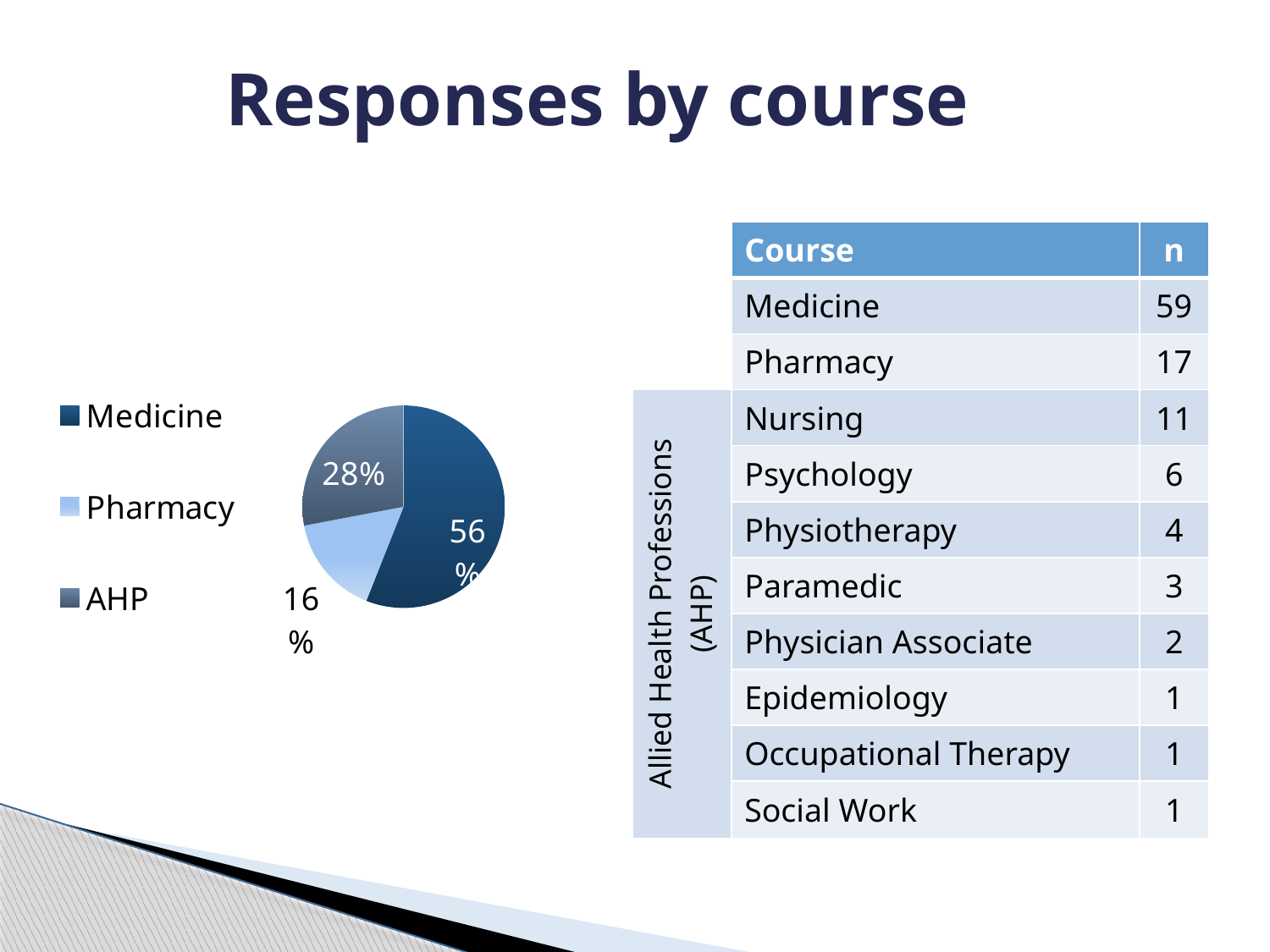
Which category has the smallest slice of the pie chart? Pharmacy What percentage of the pie chart is Pharmacy? 16% Which legend entry in the pie chart is shown in the lightest blue colour? Pharmacy What percentage of the pie chart is Medicine? 56% How many entries does the pie chart's legend list? 3 How many slices does the pie chart have? 3 What is the title of the slide containing the pie chart? Responses by course Which slice is larger in the pie chart, AHP or Pharmacy? AHP What is the difference in percentage points between the Medicine slice and the Pharmacy slice? 40 What kind of chart is shown on the slide? pie chart What percentage of the pie chart is AHP? 28% Which category has the largest slice of the pie chart? Medicine